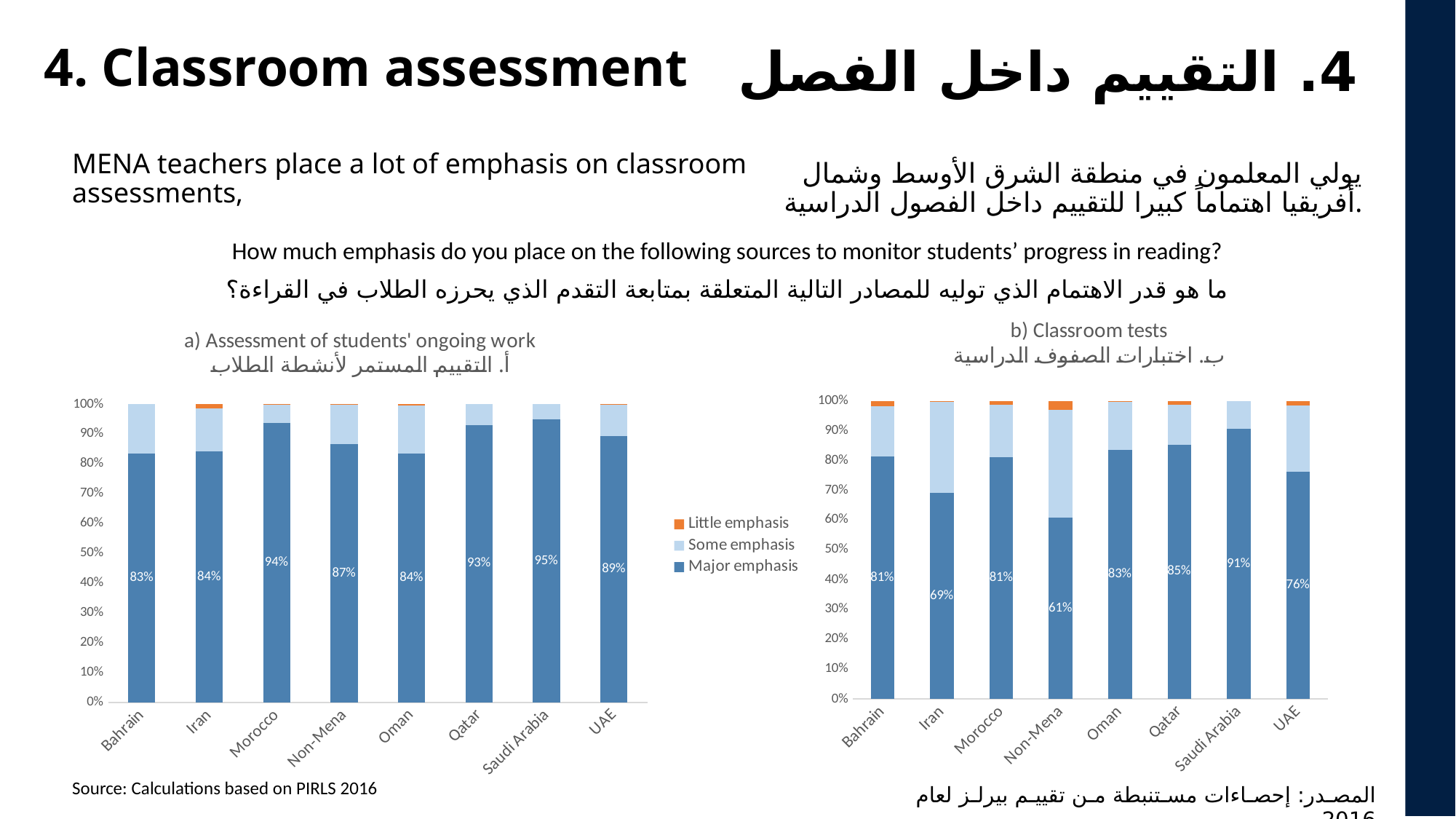
In the chart 'b) Classroom tests', which category has the lowest Major emphasis value? Non-Mena Which legend entry is shown in orange? Little emphasis In the chart 'b) Classroom tests', what is the Major emphasis value for Non-Mena? 61% In the chart 'a) Assessment of students' ongoing work', which country has the highest Major emphasis value? Saudi Arabia In the chart 'b) Classroom tests', is the Major emphasis value for Iran greater or less than 70%? less In the chart 'b) Classroom tests', what is the difference between the Major emphasis values for Qatar and Iran? 16% In the chart 'b) Classroom tests', what is the Major emphasis value for Saudi Arabia? 91% In the chart 'a) Assessment of students' ongoing work', what is the Major emphasis value for Morocco? 94% What kind of chart is 'b) Classroom tests'? Stacked bar chart How many series does the legend list for the charts on this slide? 3 In the chart 'a) Assessment of students' ongoing work', which has a larger Major emphasis value, Qatar or UAE? Qatar How many countries or categories are shown on the x axis of the chart 'a) Assessment of students' ongoing work'? 8